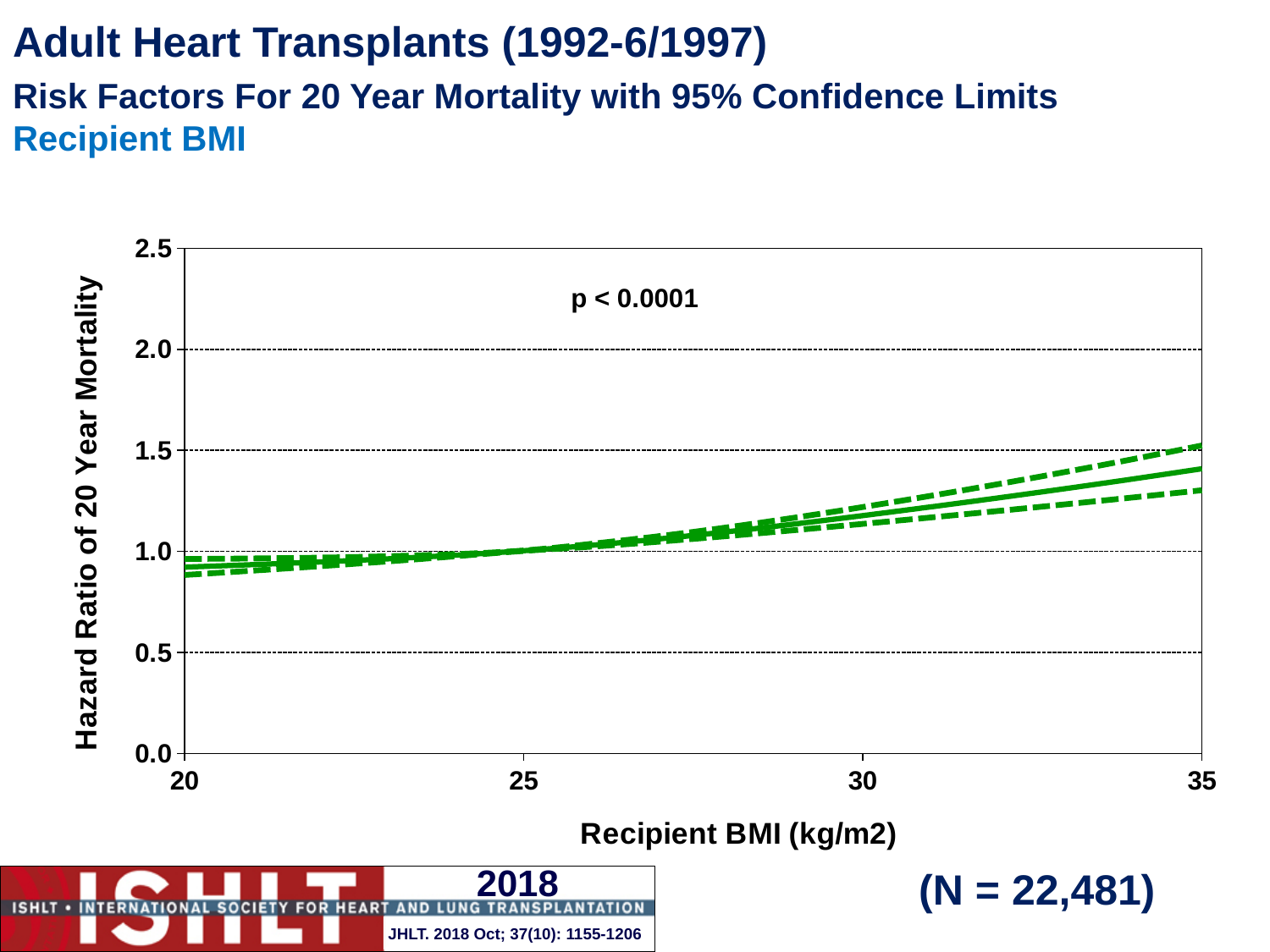
What p-value is printed on the chart? p < 0.0001 What is the label of the x axis? Recipient BMI (kg/m2) Is the hazard ratio for a recipient BMI of 30 greater or less than 1.5? less Does the hazard ratio of 20 year mortality rise or fall as recipient BMI increases from 20 to 35? rise What kind of chart is shown on the slide? line chart Which recipient BMI has the higher hazard ratio, 25 or 35? 35 How many lines are plotted on the chart (including the confidence limit lines)? 3 What is the label of the y axis? Hazard Ratio of 20 Year Mortality Is the hazard ratio for a recipient BMI of 35 greater or less than 2.0? less Is the hazard ratio for a recipient BMI of 35 greater or less than 1.0? greater What sample size (N) is shown on the slide? N = 22,481